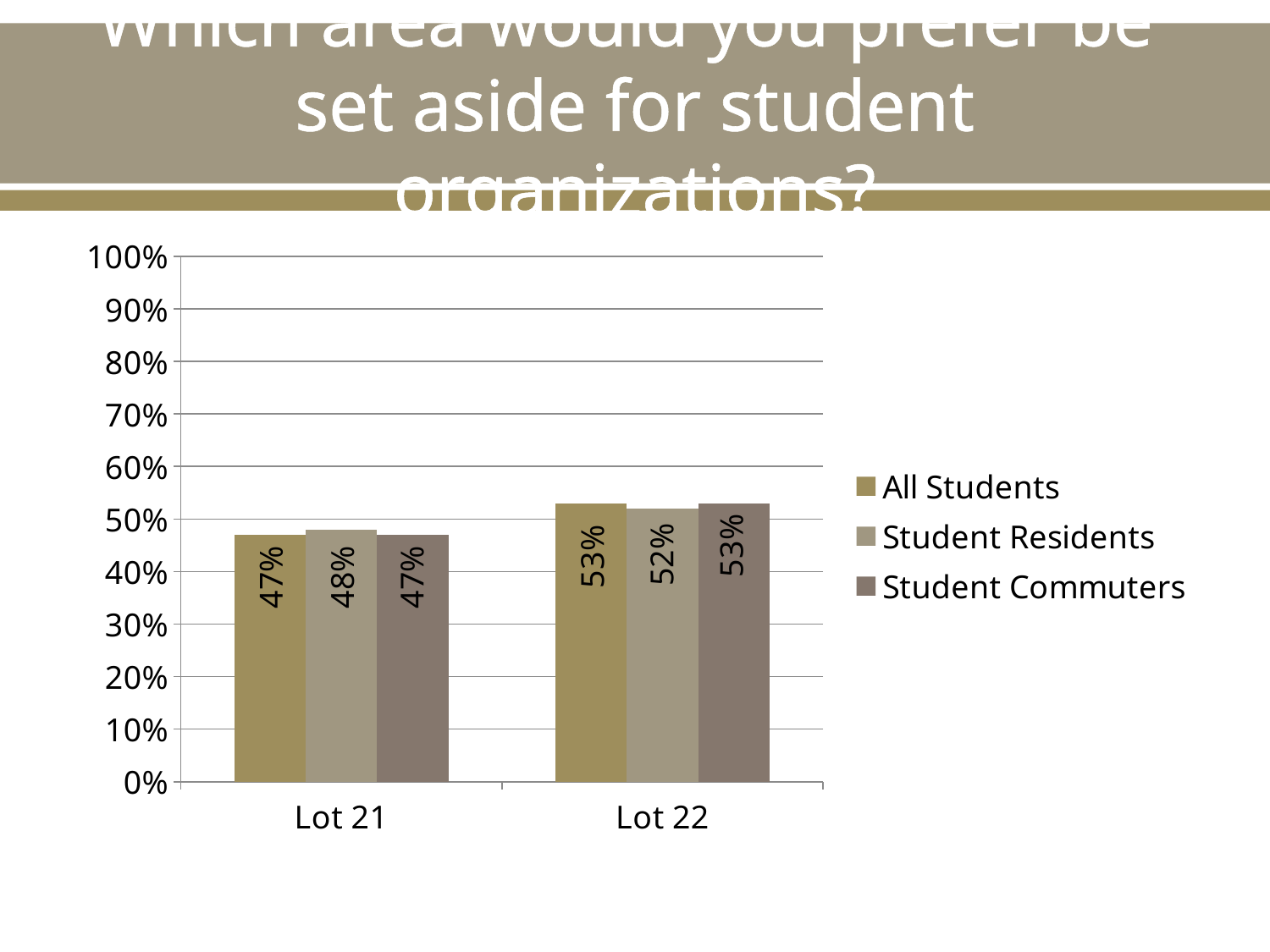
How many series does the legend list? 3 Which lot did All Students prefer more, Lot 21 or Lot 22? Lot 22 What percentage of All Students preferred Lot 21? 47% What kind of chart is shown on the slide? bar chart Which series is shown in the darkest colour in the legend? Student Commuters Is the value for Student Commuters at Lot 21 greater or less than 50%? less What percentage of Student Residents preferred Lot 21? 48% What is the difference between the Student Residents values for Lot 22 and Lot 21? 4% What percentage of Student Residents preferred Lot 22? 52% What percentage of Student Commuters preferred Lot 22? 53% How many categories are shown on the x axis? 2 What is the difference between the All Students values for Lot 22 and Lot 21? 6%